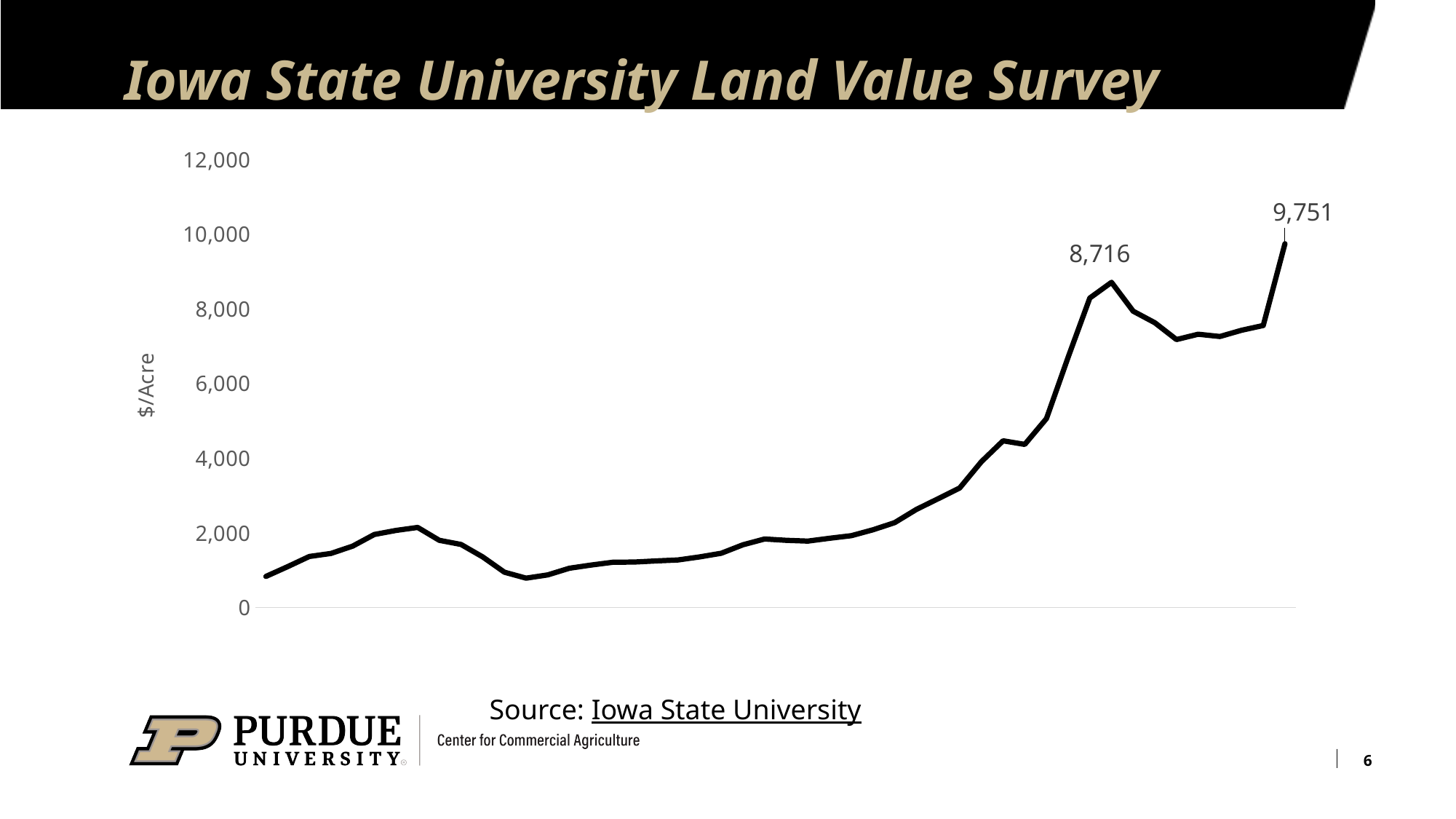
Overall, do the values rise or fall from left to right along the x axis? rise What kind of chart is shown on the slide? line chart What is the value of the labeled peak that occurs before the final rise at the right end of the line? 8,716 What is the value of the last (rightmost) point on the line? 9,751 Is the value of the final point greater or less than 8,000? greater What is the difference between the two labeled values, 9,751 and 8,716? 1,035 What is the title of the slide containing the chart? Iowa State University Land Value Survey What is the label on the vertical axis? $/Acre What is the highest value labeled on the chart? 9,751 Is the value at the leftmost (starting) point of the line greater or less than 2,000? less Which labeled value is larger, the earlier peak or the final point? the final point (9,751)